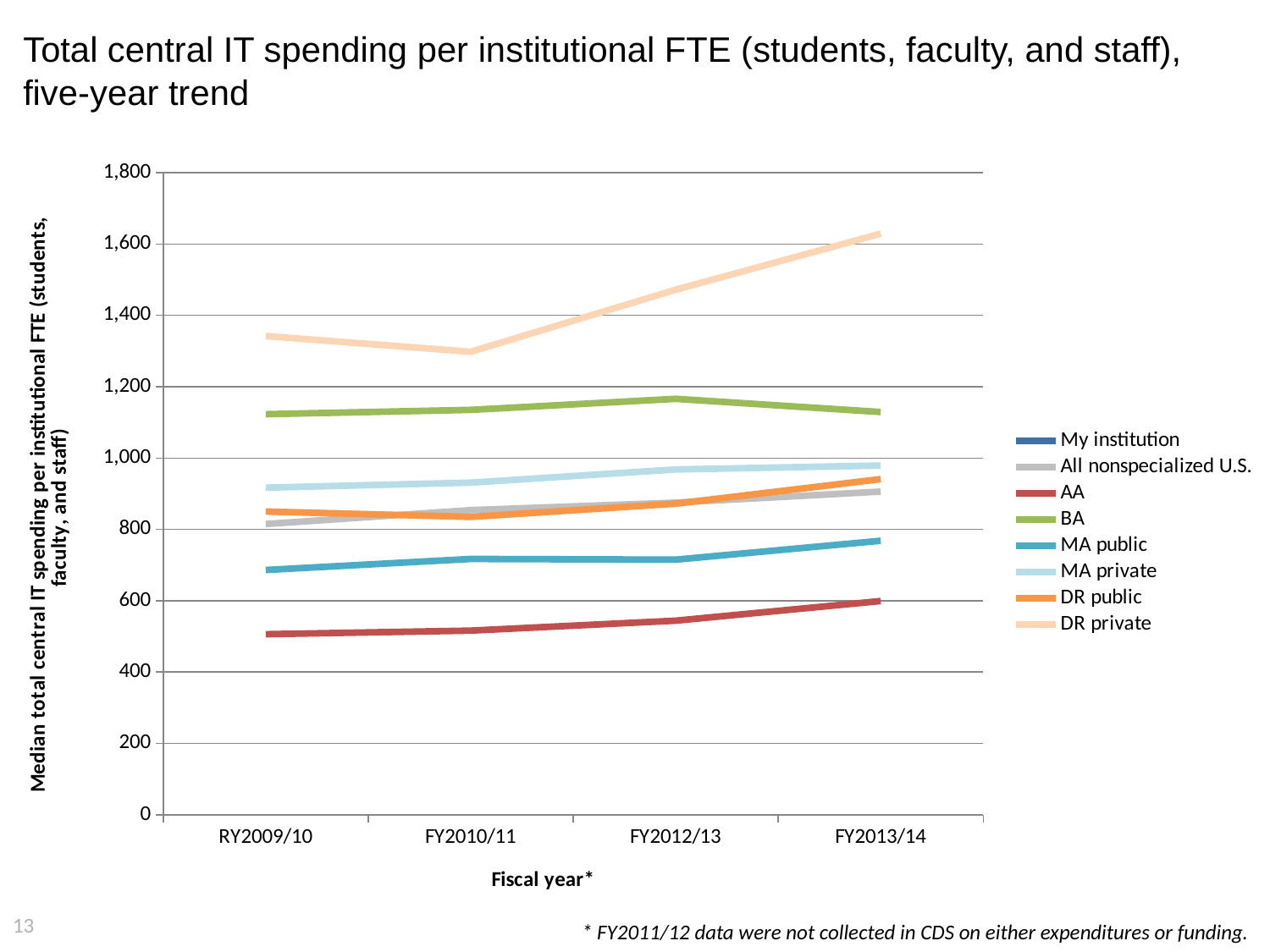
What is the label of the x axis? Fiscal year* Which series has the highest median total central IT spending per FTE in FY2013/14? DR private In FY2013/14, which is larger: the value for BA or the value for MA private? BA How many fiscal years are shown on the x axis? 4 Is the value for MA public in FY2013/14 greater or less than 800? less What kind of chart is shown on the slide? Line chart Is the value for BA in FY2012/13 greater or less than 1,000? greater Is the value for DR private in FY2013/14 greater or less than 1,400? greater How many series does the legend list? 8 Which series has the lowest median total central IT spending per FTE across all fiscal years shown? AA Does the DR private line rise or fall from FY2010/11 to FY2013/14? Rises